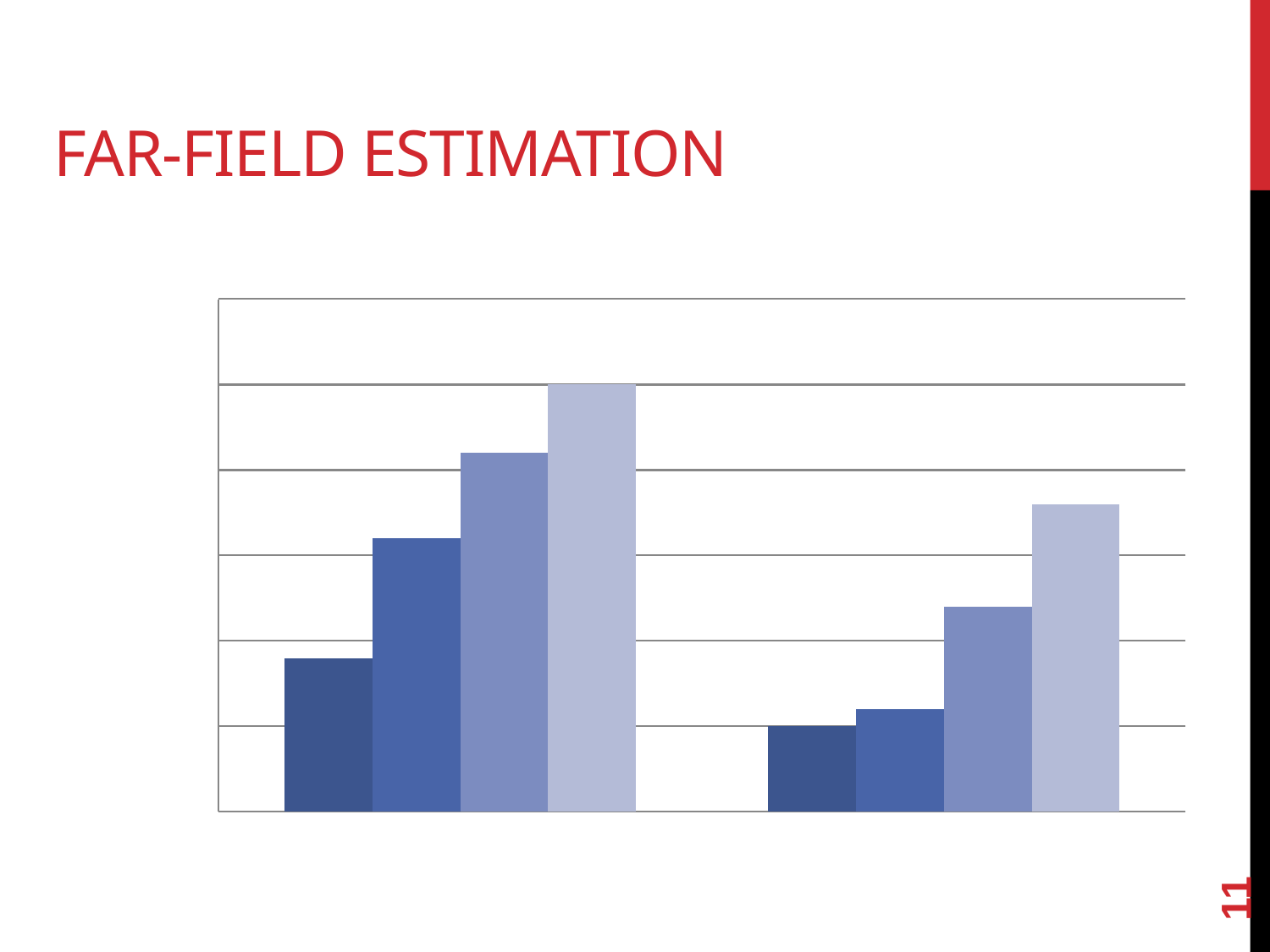
Within the right group of bars, do the values rise or fall from left to right? rise Which bar is the tallest on the chart: the lightest bar in the left group or the lightest bar in the right group? the lightest bar in the left group How many bars are plotted in total on the chart? 8 Which group of bars has the higher values overall, the left group or the right group? the left group Does the chart display a legend? No Within the left group of bars, do the values rise or fall from left to right? rise What kind of chart is shown on the slide? bar chart Which bar is the shortest on the chart: the darkest bar in the left group or the darkest bar in the right group? the darkest bar in the right group In the left group, which bar is the tallest: the darkest bar or the lightest bar? the lightest bar How many groups of bars does the chart contain? 2 How many bars are in each group of the chart? 4 What is the title of the slide containing the chart? FAR-FIELD ESTIMATION